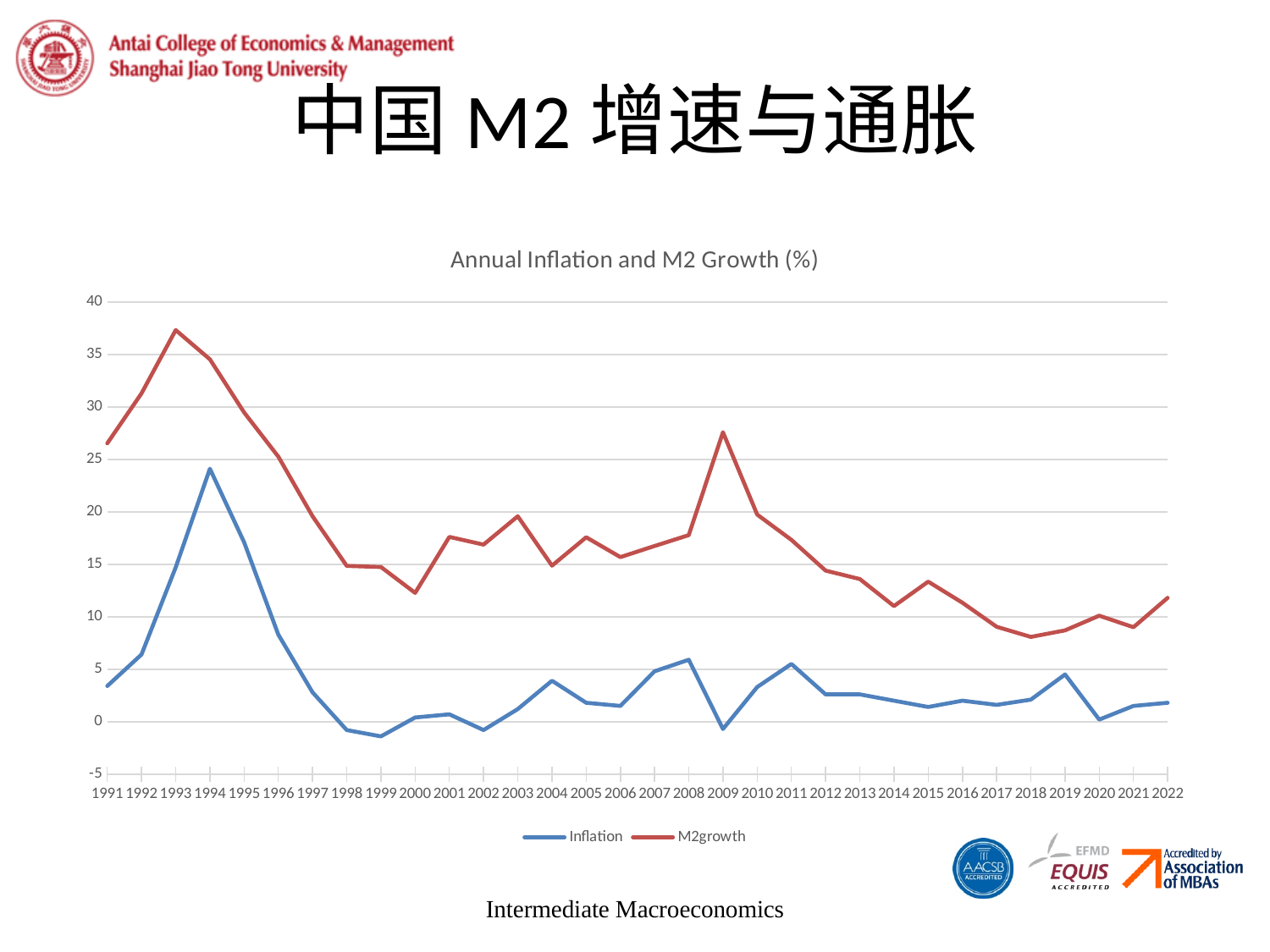
Is the M2growth value for 2018 greater or less than 10? less Which is larger, the M2growth value for 1993 or for 2009? 1993 Does the M2growth series rise or fall from 2009 to 2018? Fall Is the Inflation value for 1999 greater or less than 0? less In which year does the Inflation series reach its highest value? 1994 How many series does the legend list? 2 Is the M2growth value for 1993 greater or less than 35? greater How many years are plotted along the x axis? 32 What is the title of the chart? Annual Inflation and M2 Growth (%) In which year does the M2growth series reach its highest value? 1993 What kind of chart is shown on the slide? Line chart